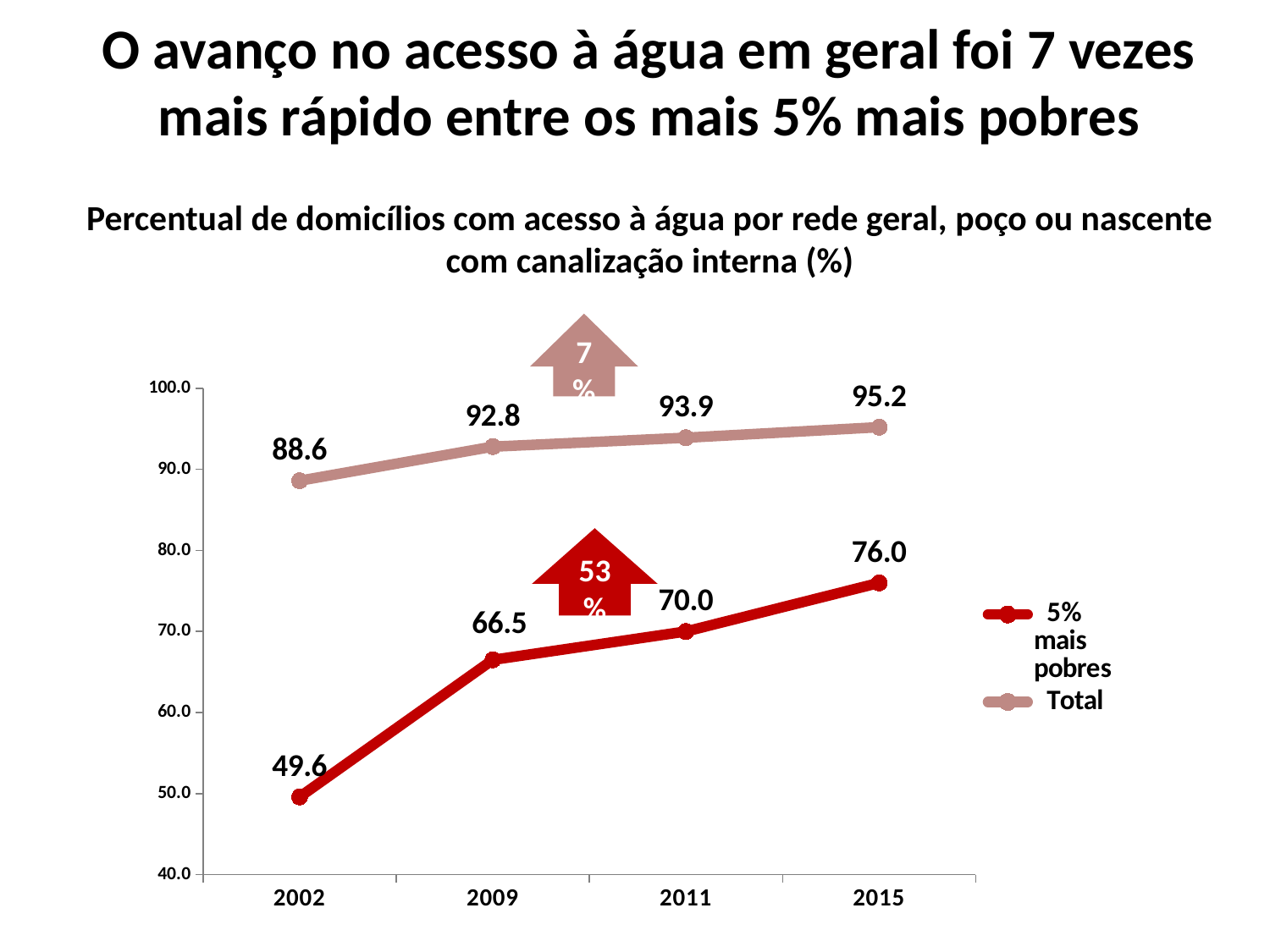
By how much did the '5% mais pobres' value increase from 2002 to 2015? 26.4 How many series does the legend list? 2 How many years are shown on the x axis? 4 What is the value for '5% mais pobres' in 2002? 49.6 What is the value for 'Total' in 2009? 92.8 What is the value for 'Total' in 2015? 95.2 What is the value for '5% mais pobres' in 2011? 70.0 In which year is the 'Total' series lowest? 2002 What is the difference between the 'Total' and '5% mais pobres' values in 2015? 19.2 In which year is the '5% mais pobres' series highest? 2015 What kind of chart is shown on the slide? Line chart Which series has the higher value in 2009, '5% mais pobres' or 'Total'? Total